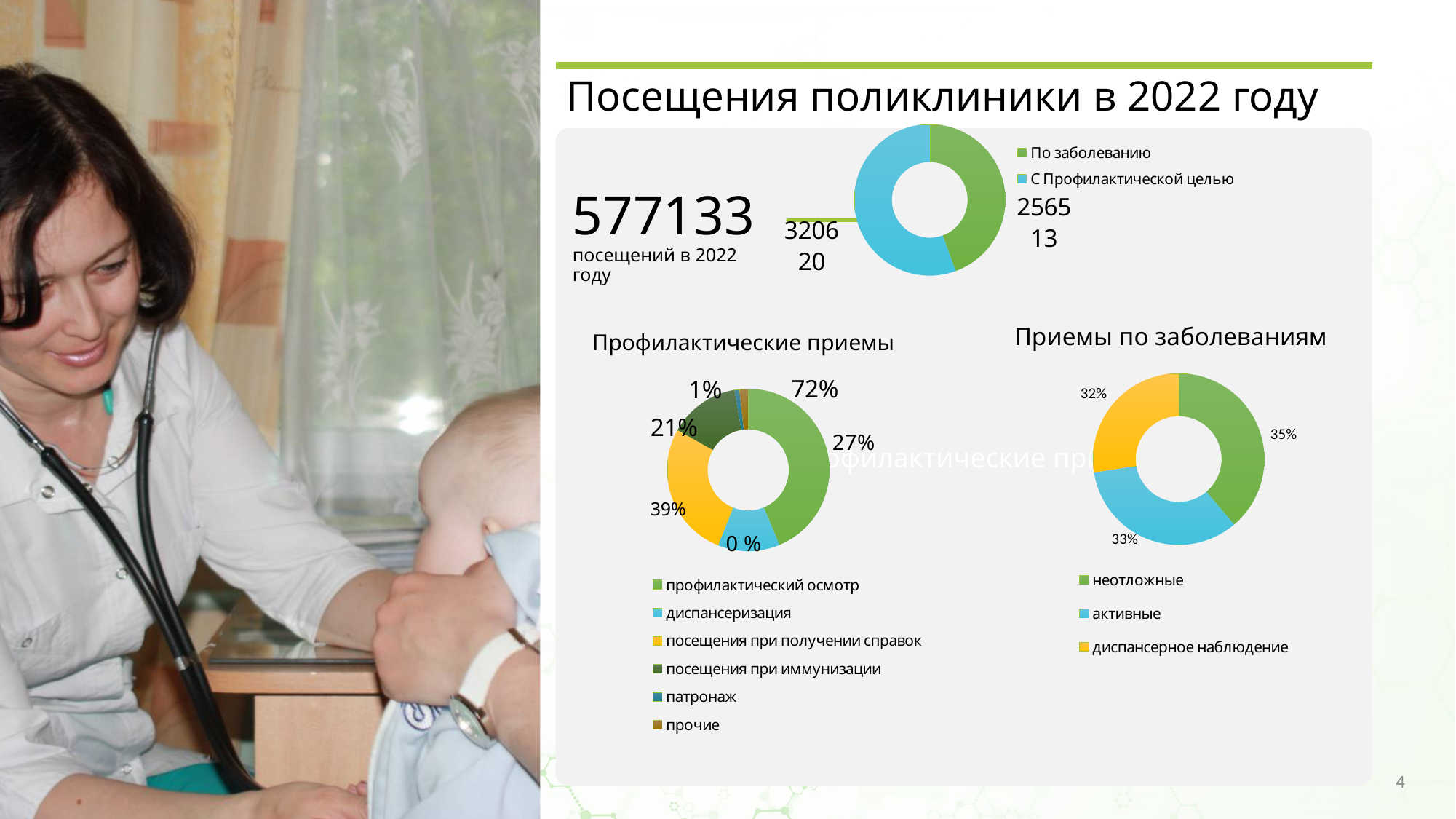
How many categories does the legend of the chart 'Приемы по заболеваниям' list? 3 In the chart 'Профилактические приемы', which colour represents 'диспансеризация' in the legend? Light blue In the chart 'Приемы по заболеваниям', which category has the largest share? неотложные What kind of chart is 'Приемы по заболеваниям'? Donut (pie) chart In the chart 'Приемы по заболеваниям', which category has the smallest share? диспансерное наблюдение In the chart 'Приемы по заболеваниям', what is the share for 'активные'? 33% In the top donut chart next to the number 577133, which category has the larger share: 'По заболеванию' or 'С Профилактической целью'? С Профилактической целью How many categories does the legend of the top donut chart (next to 577133) list? 2 In the chart 'Приемы по заболеваниям', what is the share for 'диспансерное наблюдение'? 32% How many categories does the legend of the chart 'Профилактические приемы' list? 6 In the chart 'Приемы по заболеваниям', what is the share for 'неотложные'? 35% In the chart 'Приемы по заболеваниям', what is the difference in percentage points between 'неотложные' and 'активные'? 2